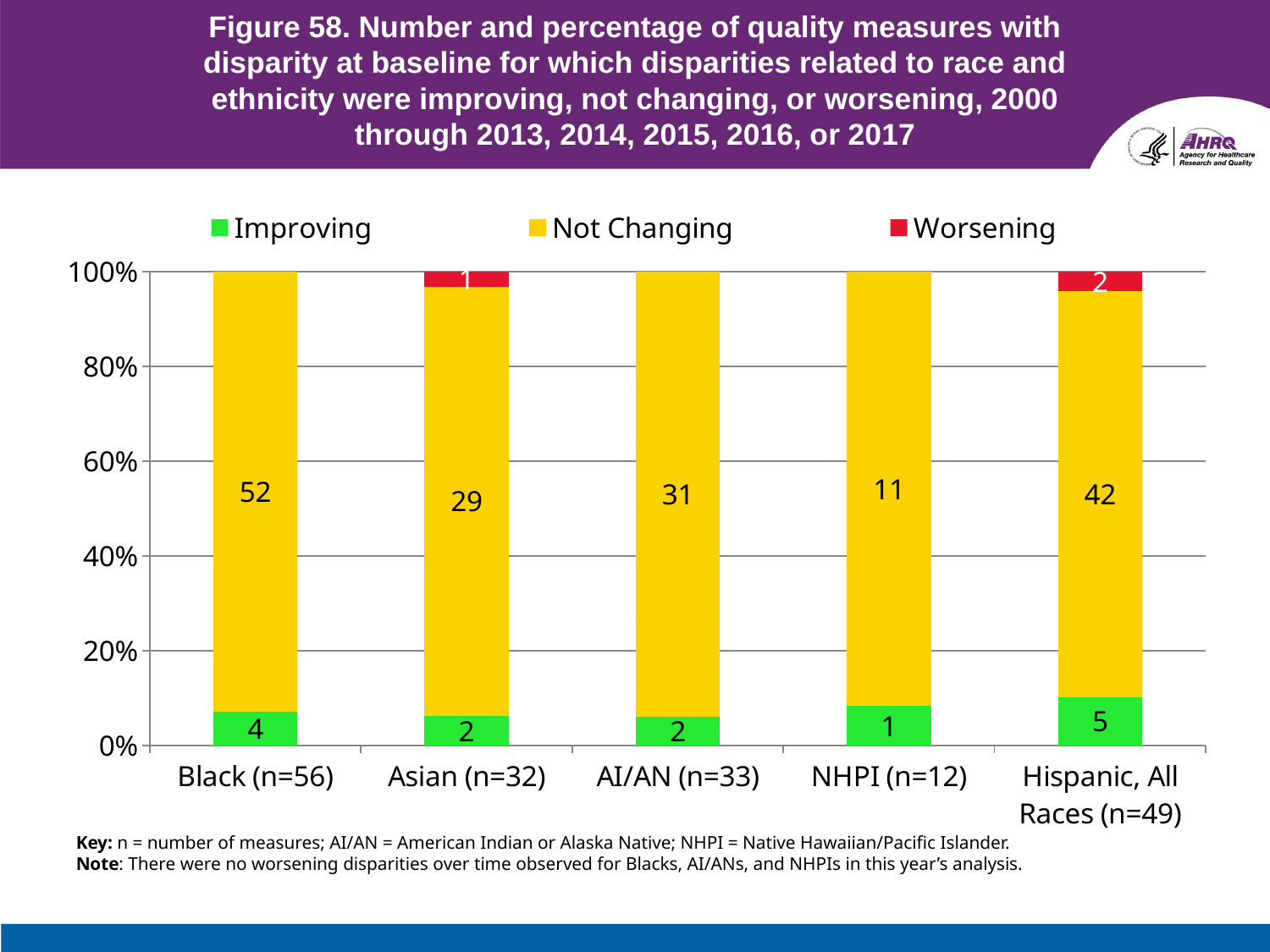
What kind of chart is shown? Stacked bar chart What is the number of Improving measures for Hispanic, All Races (n=49)? 5 What is the number of Improving measures for NHPI (n=12)? 1 How many series does the legend list? 3 Which group has the highest number of Not Changing measures? Black (n=56) Which has more Improving measures, Black (n=56) or Asian (n=32)? Black (n=56) What is the number of Worsening measures for Asian (n=32)? 1 What is the number of Not Changing measures for Black (n=56)? 52 What is the difference between the Not Changing counts for Black (n=56) and Hispanic, All Races (n=49)? 10 Which group has the lowest number of Not Changing measures? NHPI (n=12) Which colour represents the Worsening series? Red How many groups are shown on the x axis? 5